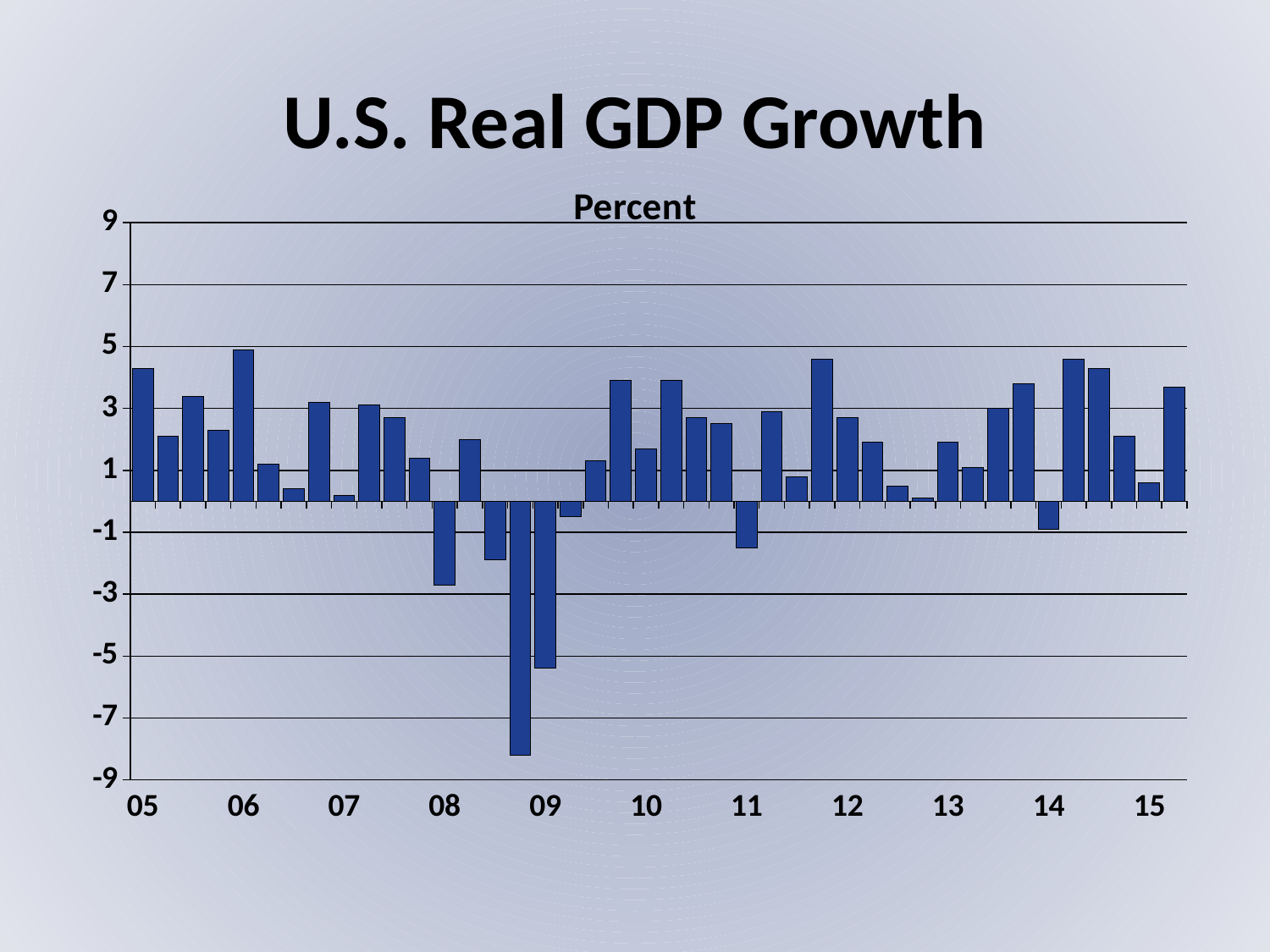
What is the highest value shown on the vertical axis? 9 Is the value of the lowest bar on the chart greater or less than -7? less What is the lowest value shown on the vertical axis? -9 Is the value of the first bar above the 06 label greater or less than 3? greater Is the value of the tallest bar on the chart greater or less than 3? greater Do the bars for 2009 rise or fall from the first quarter to the last quarter of the year? rise Which is larger, the bar directly above the 06 label or the bar directly above the 07 label? the bar above 06 What unit label is shown above the vertical axis? Percent What is the title of the chart? U.S. Real GDP Growth What kind of chart is shown on the slide? bar chart How many year labels are shown along the x axis? 11